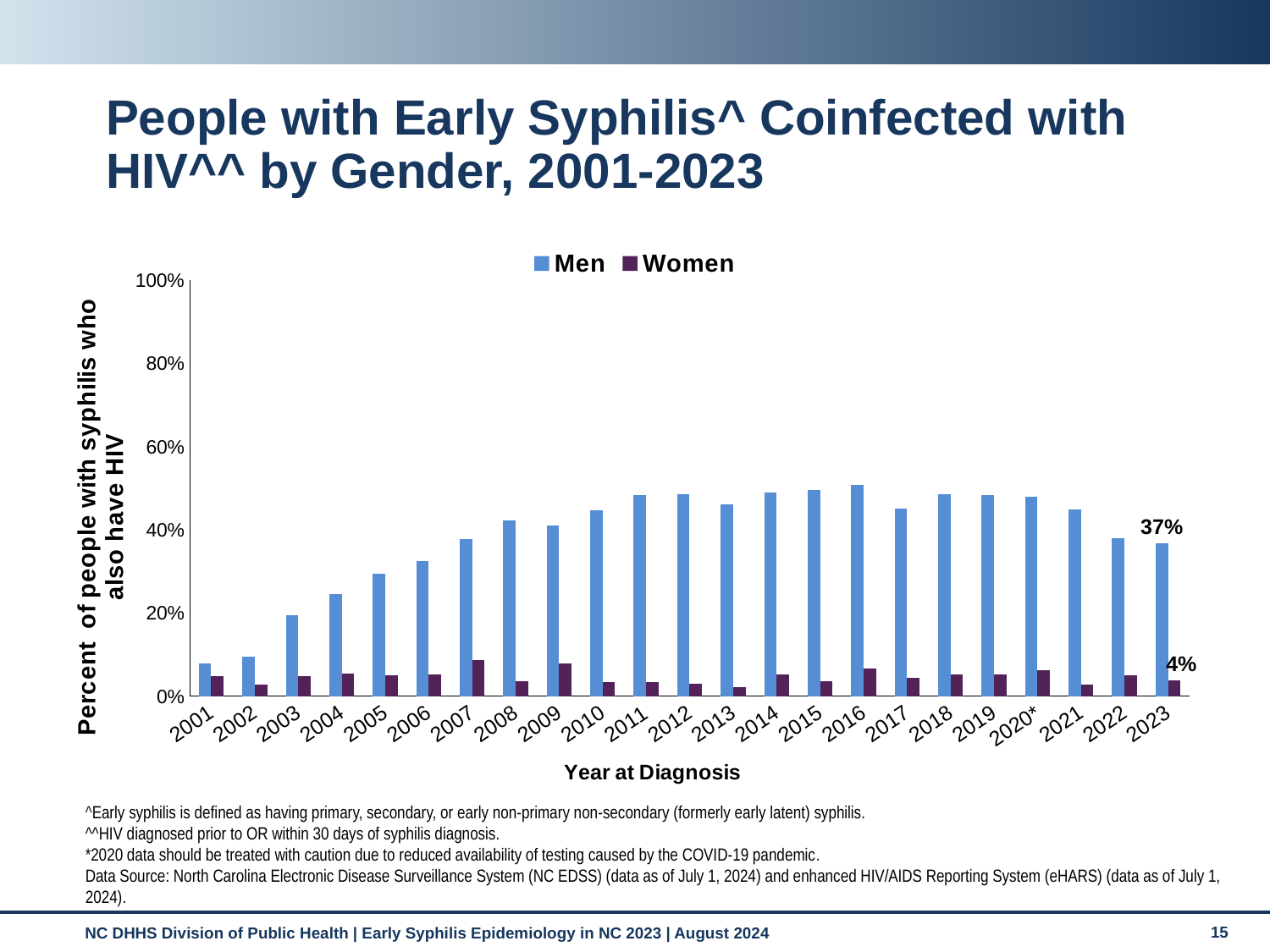
What is the value for Men in 2023? 37% Do the values for Men rise or fall from 2001 to 2011? Rise In which year is the value for Men the lowest? 2001 How many years are shown on the x axis? 23 Is the value for Men in 2016 greater or less than 40%? greater Is the value for Men in 2001 greater or less than 20%? less What is the difference between the Men and Women values in 2023? 33 percentage points In 2023, which series has the larger value, Men or Women? Men What kind of chart is shown on the slide? Bar chart Is the value for Women in 2007 greater or less than 20%? less What is the value for Women in 2023? 4% How many series does the legend list? 2